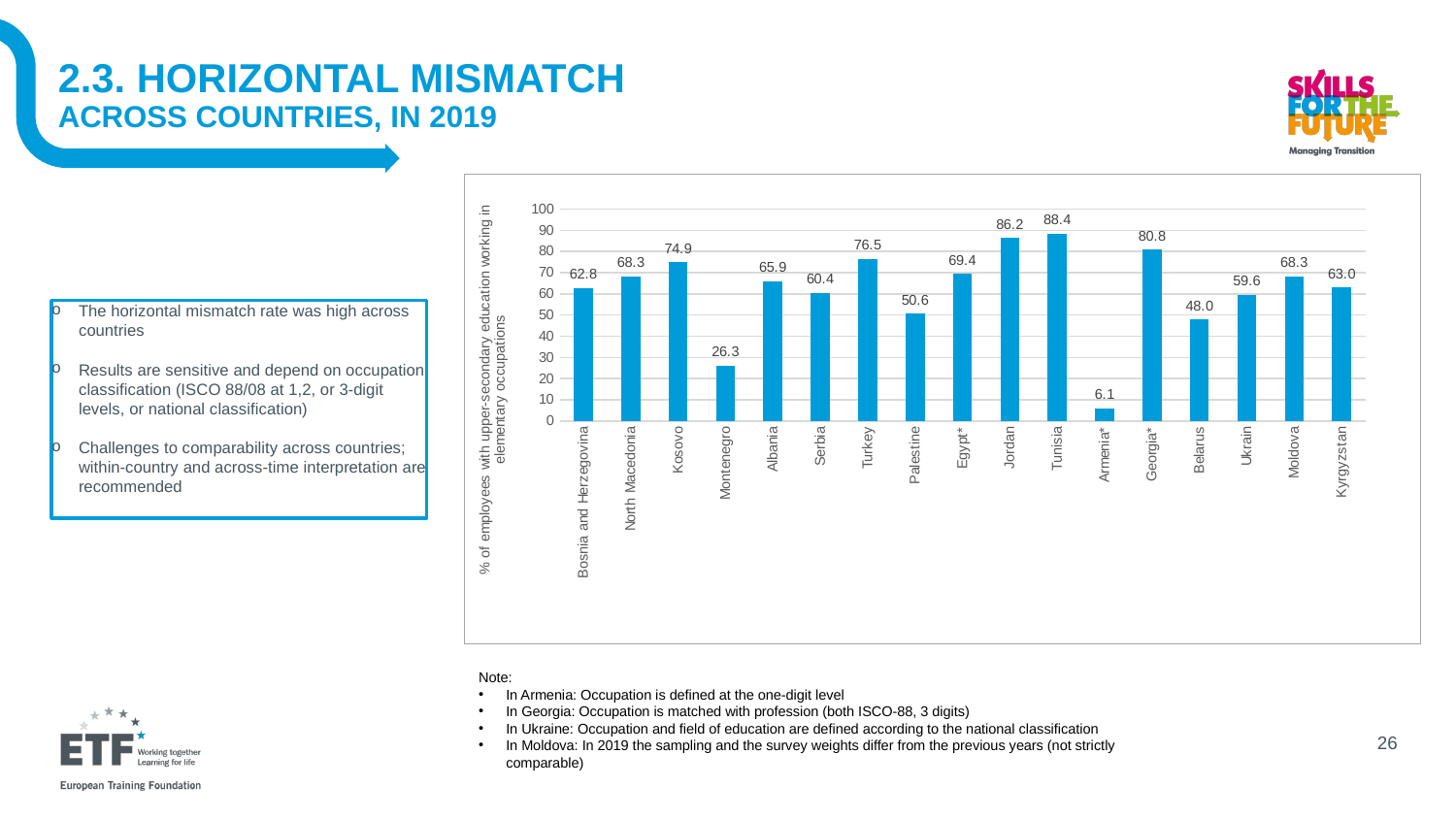
What is the value for Kyrgyzstan? 63.0 Which is larger, the value for Kosovo or the value for Turkey? Turkey Is the value for Georgia* greater or less than 70? greater How many countries are shown on the x axis? 17 What is the difference between the values for Serbia and Ukrain? 0.8 What is the value for Belarus? 48.0 What is the difference between the values for Jordan and Palestine? 35.6 What is the value for Montenegro? 26.3 What is the value for Tunisia? 88.4 Which country has the highest value? Tunisia Which country has the lowest value? Armenia* What kind of chart is shown on the slide? bar chart